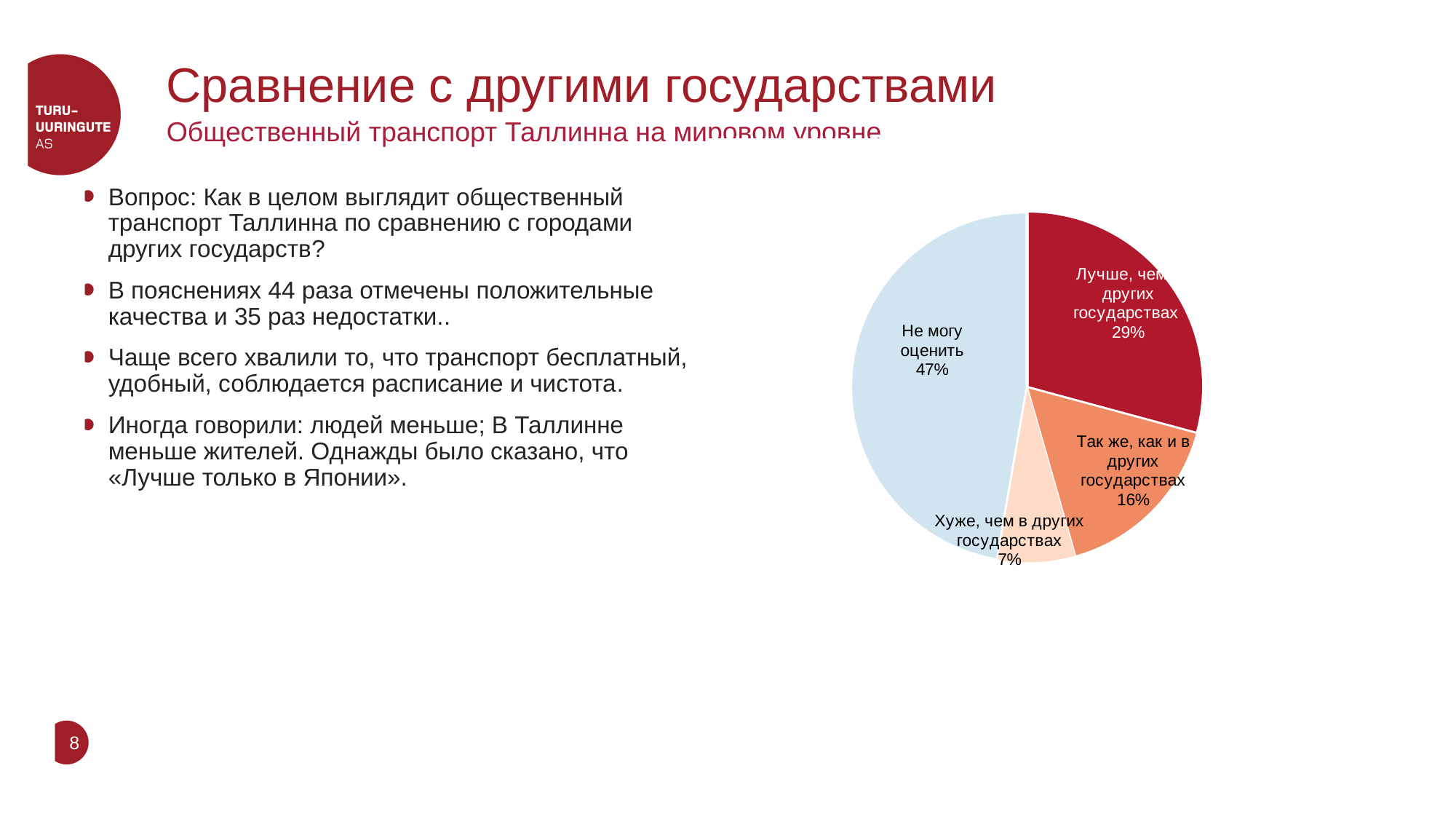
What colour is the "Не могу оценить" slice of the pie? light blue What is the difference in percentage points between "Так же, как и в других государствах" and "Хуже, чем в других государствах"? 9 What share of the pie is labelled "Лучше, чем в других государствах"? 29% What share of the pie is labelled "Хуже, чем в других государствах"? 7% Which slice of the pie is the largest? Не могу оценить What is the difference in percentage points between "Не могу оценить" and "Лучше, чем в других государствах"? 18 Which is larger: the share for "Лучше, чем в других государствах" or the share for "Так же, как и в других государствах"? Лучше, чем в других государствах What share of the pie is labelled "Не могу оценить"? 47% How many slices does the pie chart have? 4 Which slice of the pie is the smallest? Хуже, чем в других государствах What share of the pie is labelled "Так же, как и в других государствах"? 16% What kind of chart is shown on the slide? pie chart